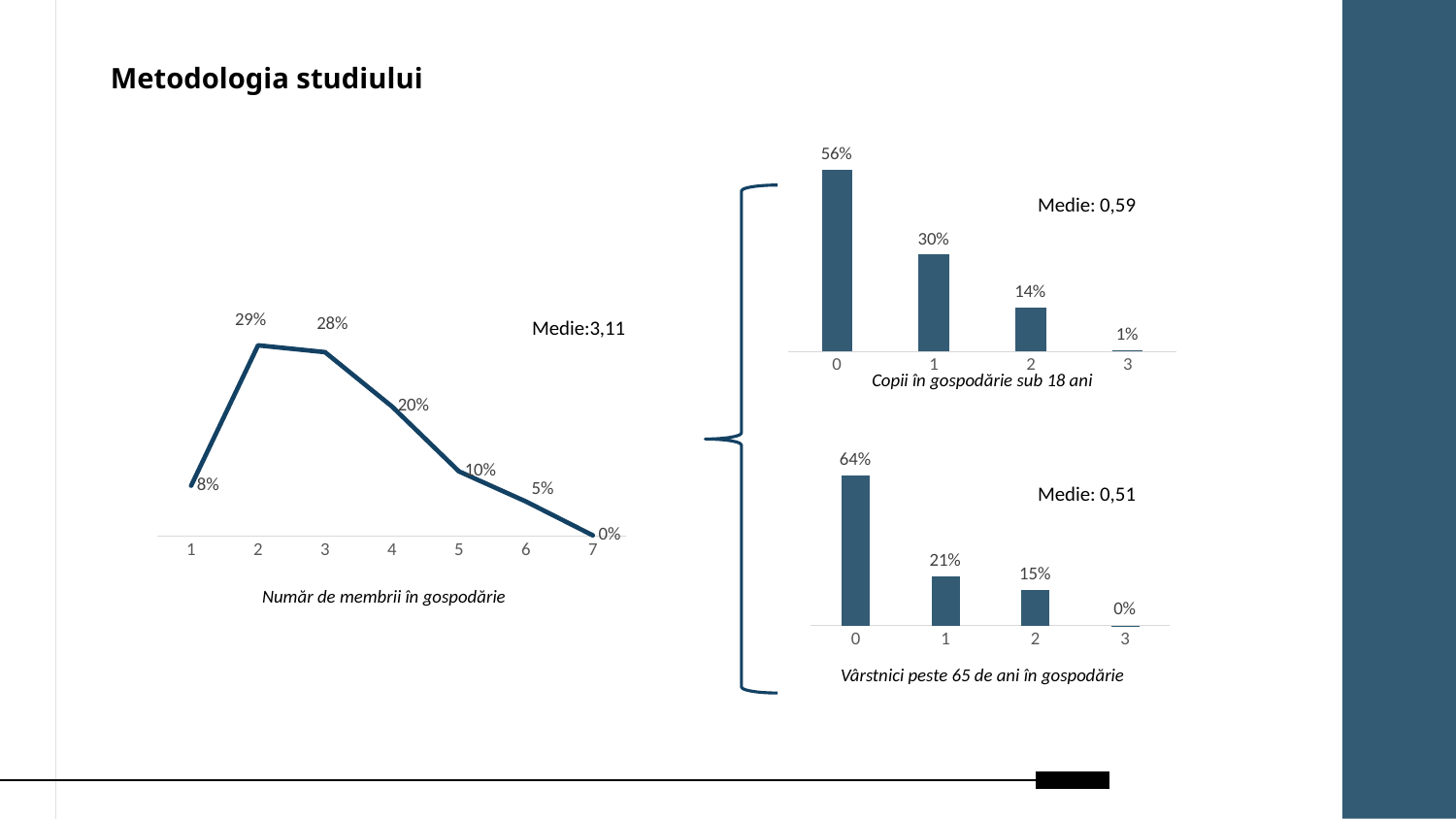
In the chart 'Vârstnici peste 65 de ani în gospodărie', what is the value for 2 elderly persons? 15% In the chart 'Număr de membrii în gospodărie', what is the value for 5 members? 10% Which is larger: the value for 0 in 'Vârstnici peste 65 de ani în gospodărie' or the value for 0 in 'Copii în gospodărie sub 18 ani'? Vârstnici peste 65 de ani în gospodărie (64%) In the chart 'Număr de membrii în gospodărie', what is the value for 2 members? 29% In the chart 'Copii în gospodărie sub 18 ani', what is the difference between the values for 1 child and 2 children? 16% What kind of chart is 'Număr de membrii în gospodărie'? Line chart In the chart 'Copii în gospodărie sub 18 ani', what is the value for 0 children? 56% In the chart 'Număr de membrii în gospodărie', which number of members has the highest value? 2 In the chart 'Număr de membrii în gospodărie', how many points are plotted on the x axis? 7 In the chart 'Copii în gospodărie sub 18 ani', which category has the lowest value? 3 In the chart 'Număr de membrii în gospodărie', do the values rise or fall from 3 members to 7 members? Fall What is the mean (Medie) shown for the chart 'Vârstnici peste 65 de ani în gospodărie'? 0,51